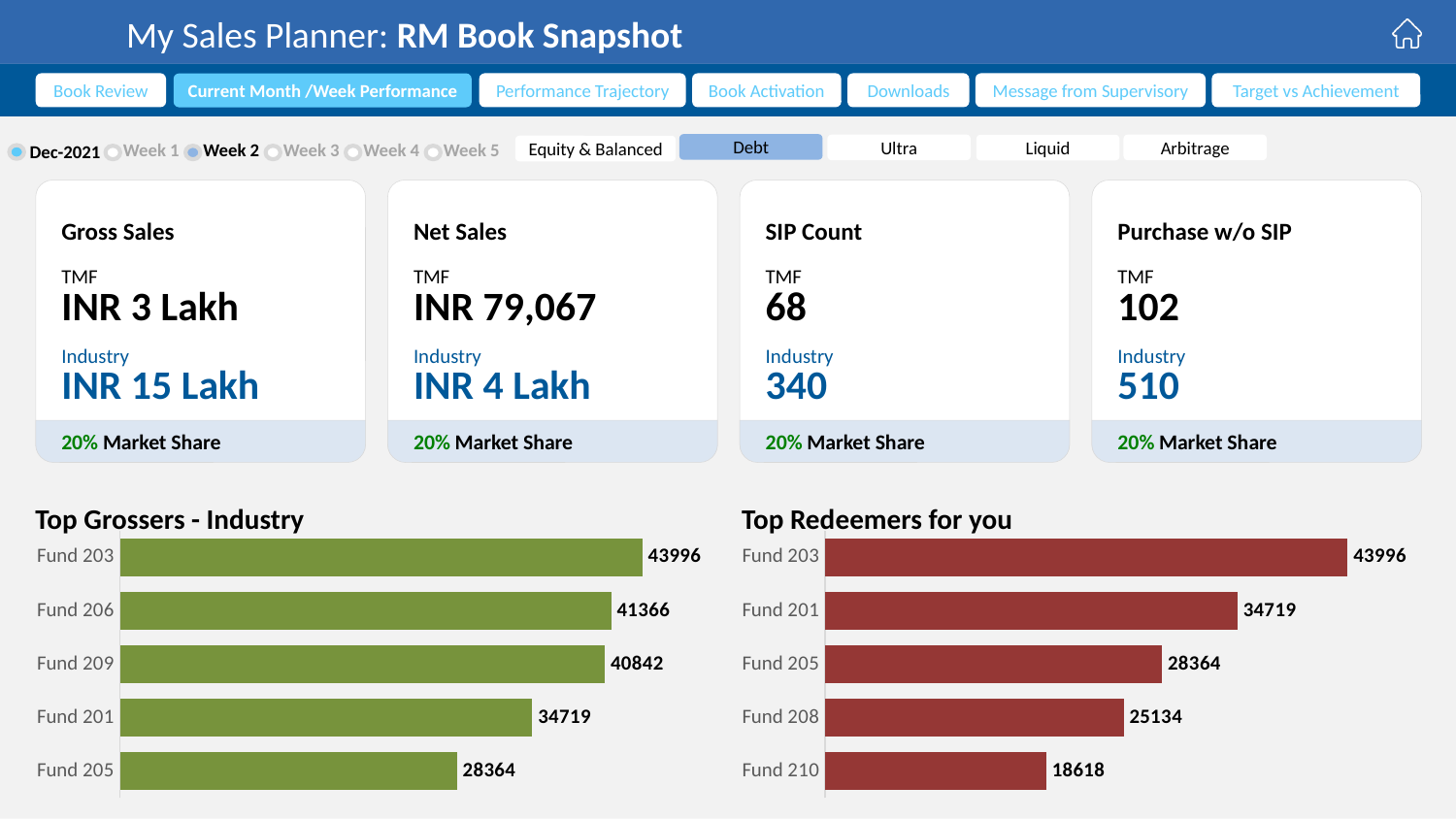
In the 'Top Redeemers for you' chart, what is the difference between the values for Fund 201 and Fund 210? 16101 In the 'Top Grossers - Industry' chart, what is the value for Fund 206? 41366 How many funds are shown in the 'Top Grossers - Industry' chart? 5 In the 'Top Grossers - Industry' chart, which fund has the highest value? Fund 203 In the 'Top Redeemers for you' chart, what is the value for Fund 208? 25134 What type of chart is the 'Top Redeemers for you' chart? Bar chart In the 'Top Grossers - Industry' chart, what is the difference between the values for Fund 203 and Fund 205? 15632 In the 'Top Redeemers for you' chart, which is larger: the value for Fund 205 or the value for Fund 208? Fund 205 In the 'Top Redeemers for you' chart, which fund has the lowest value? Fund 210 How many funds are shown in the 'Top Redeemers for you' chart? 5 In the 'Top Grossers - Industry' chart, which is larger: the value for Fund 209 or the value for Fund 201? Fund 209 In the 'Top Grossers - Industry' chart, what is the value for Fund 209? 40842